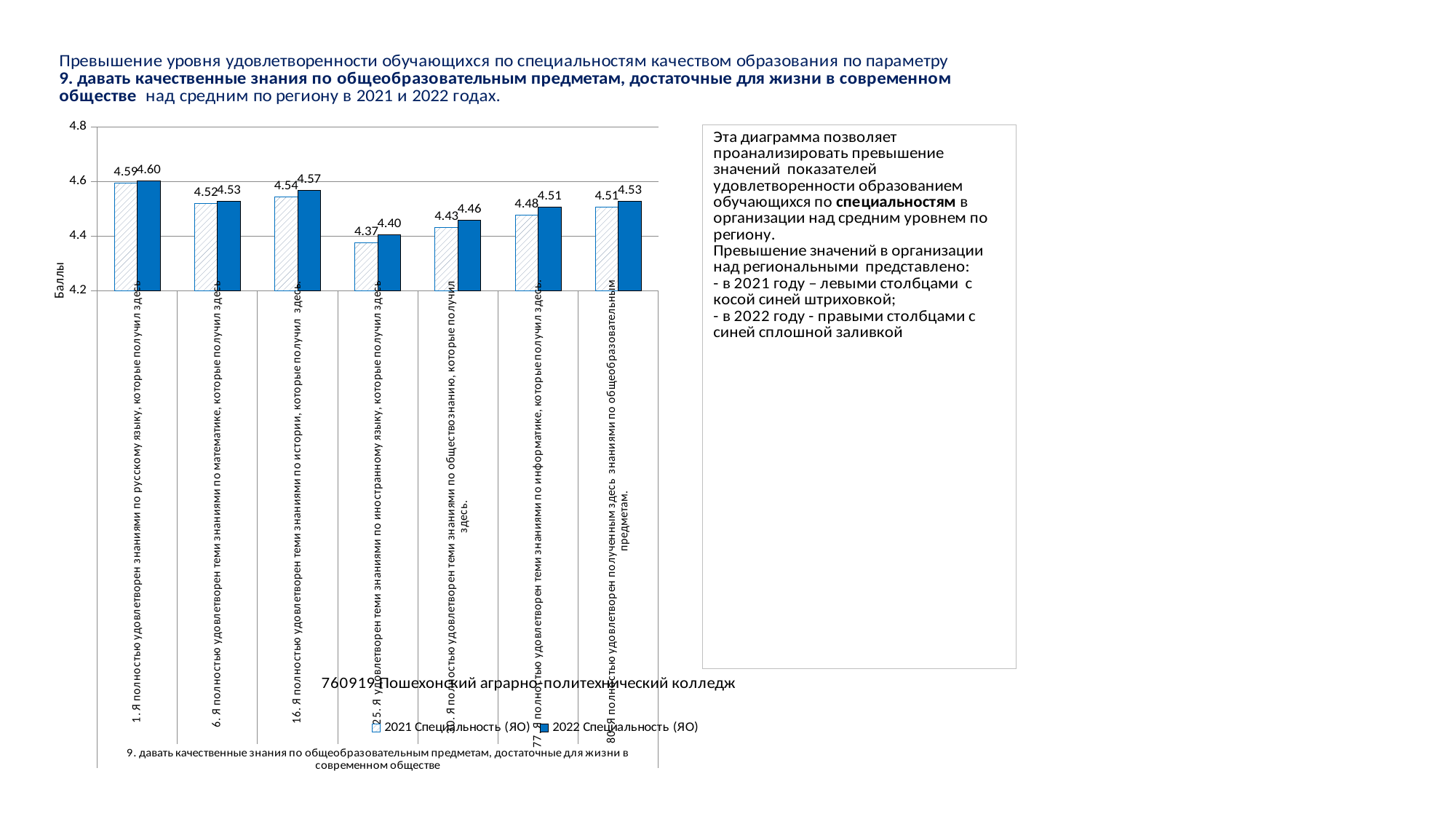
How many series does the chart legend list? 2 What is the 2021 value for the category about knowledge of the Russian language (1. Я полностью удовлетворен знаниями по русскому языку)? 4.59 Which category has the highest 2022 value? 1. Я полностью удовлетворен знаниями по русскому языку, которые получил здесь (4.60) What kind of chart is shown on the slide? Bar chart What is the 2021 value for the category about knowledge of a foreign language (25. ... по иностранному языку)? 4.37 What are the two series named in the chart legend? 2021 Специальность (ЯО) and 2022 Специальность (ЯО) How many categories are shown on the x axis of the chart? 7 Which category has the lowest 2021 value? 25. Я удовлетворен теми знаниями по иностранному языку, которые получил здесь (4.37) What is the 2022 value for the category about knowledge of informatics (77. ... по информатике)? 4.51 Which is larger: the 2021 value for mathematics (6.) or the 2021 value for history (16.)? History (16.), 4.54 What is the 2022 value for the category about knowledge of history (16. Я полностью удовлетворен теми знаниями по истории)? 4.57